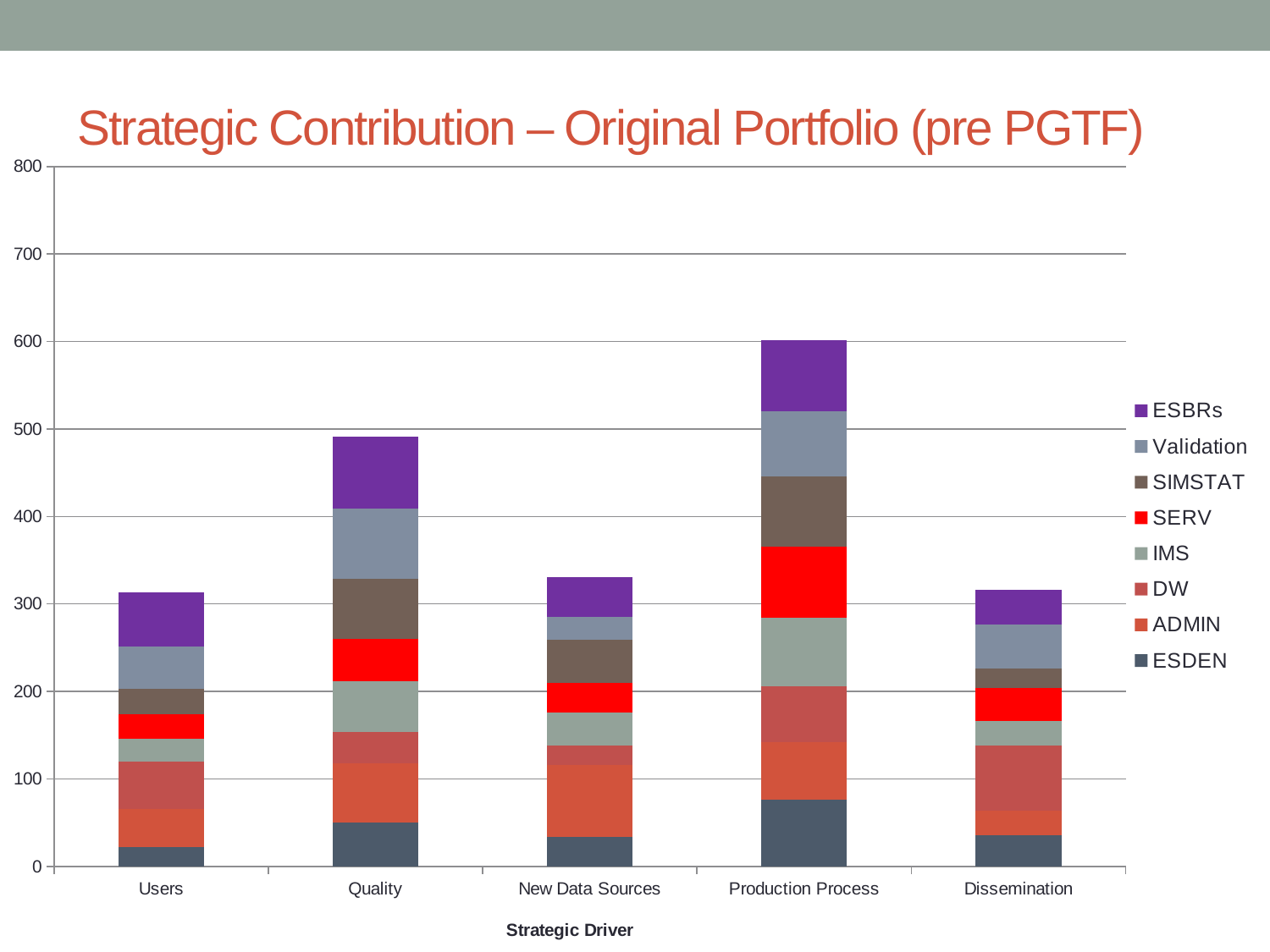
Is the total for New Data Sources greater or less than 300? greater What is the title of the chart? Strategic Contribution – Original Portfolio (pre PGTF) Which has the larger total stacked bar, Quality or New Data Sources? Quality What is the label of the x axis? Strategic Driver How many series does the legend list? 8 Which has the larger total stacked bar, Production Process or Dissemination? Production Process Is the total for Production Process greater or less than 500? greater Is the total for Quality greater or less than 400? greater What kind of chart is shown on the slide? Stacked bar chart Which strategic driver has the highest total stacked bar? Production Process How many strategic driver categories are shown on the x axis? 5